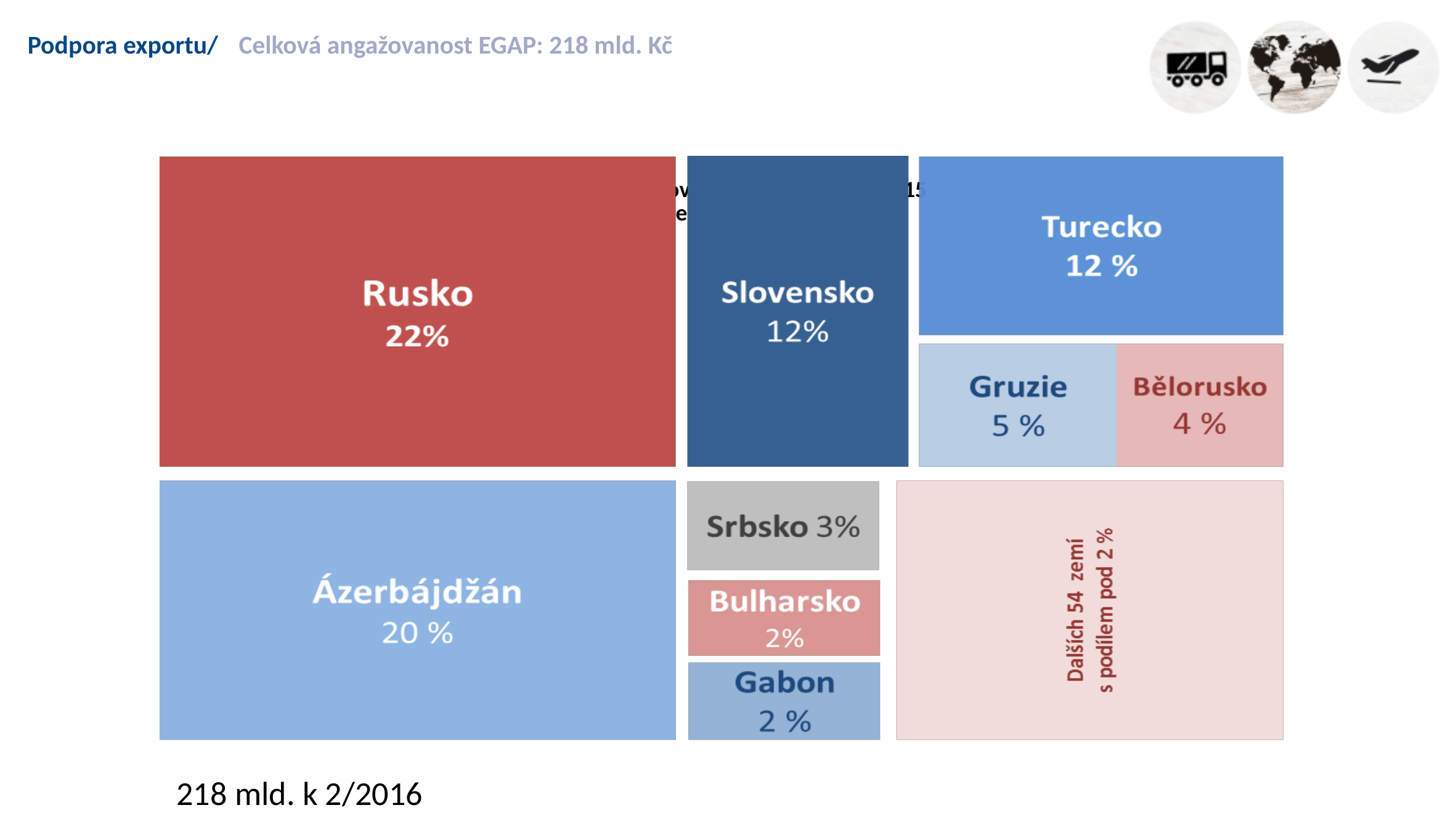
What kind of chart is shown on the slide? treemap What share is shown for Ázerbájdžán? 20 % Which has a larger share, Slovensko or Bělorusko? Slovensko What share is shown for Bělorusko? 4 % How many other countries are grouped in the block with shares below 2 %? 54 What share does Rusko have in the treemap? 22% What share is shown for Gruzie? 5 % What share is shown for Srbsko? 3% What is the difference in percentage points between Turecko and Gruzie? 7 What is the difference in percentage points between Rusko and Ázerbájdžán? 2 Which country has the largest share in the treemap? Rusko Which has a larger share, Gruzie or Srbsko? Gruzie